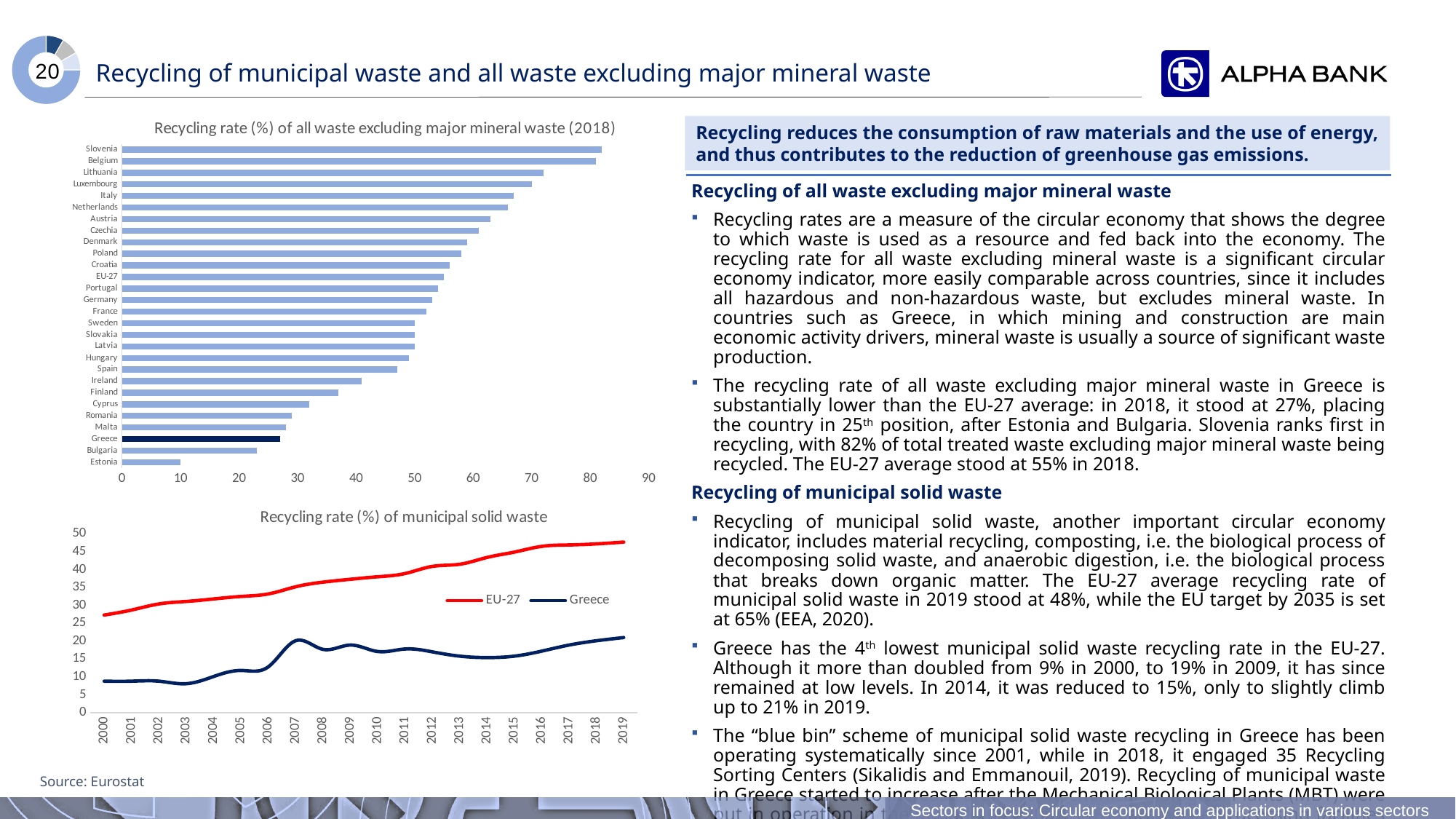
In the chart 'Recycling rate (%) of all waste excluding major mineral waste (2018)', is the value for Slovenia greater or less than 80? greater In the chart 'Recycling rate (%) of municipal solid waste', is the EU-27 value for 2019 greater or less than 45? greater In the chart 'Recycling rate (%) of all waste excluding major mineral waste (2018)', is the value for Ireland greater or less than 50? less What type of chart is 'Recycling rate (%) of all waste excluding major mineral waste (2018)'? Bar chart In the chart 'Recycling rate (%) of municipal solid waste', which series has the higher value in 2019, EU-27 or Greece? EU-27 In the chart 'Recycling rate (%) of municipal solid waste', does the EU-27 line rise or fall from 2000 to 2019? Rise In the chart 'Recycling rate (%) of municipal solid waste', how many series does the legend list? 2 In the chart 'Recycling rate (%) of all waste excluding major mineral waste (2018)', which country has the highest recycling rate? Slovenia How many countries/entities are shown as bars in the chart 'Recycling rate (%) of all waste excluding major mineral waste (2018)'? 28 In the chart 'Recycling rate (%) of all waste excluding major mineral waste (2018)', which has the higher recycling rate, Greece or Bulgaria? Greece In the chart 'Recycling rate (%) of all waste excluding major mineral waste (2018)', which country has the lowest recycling rate? Estonia